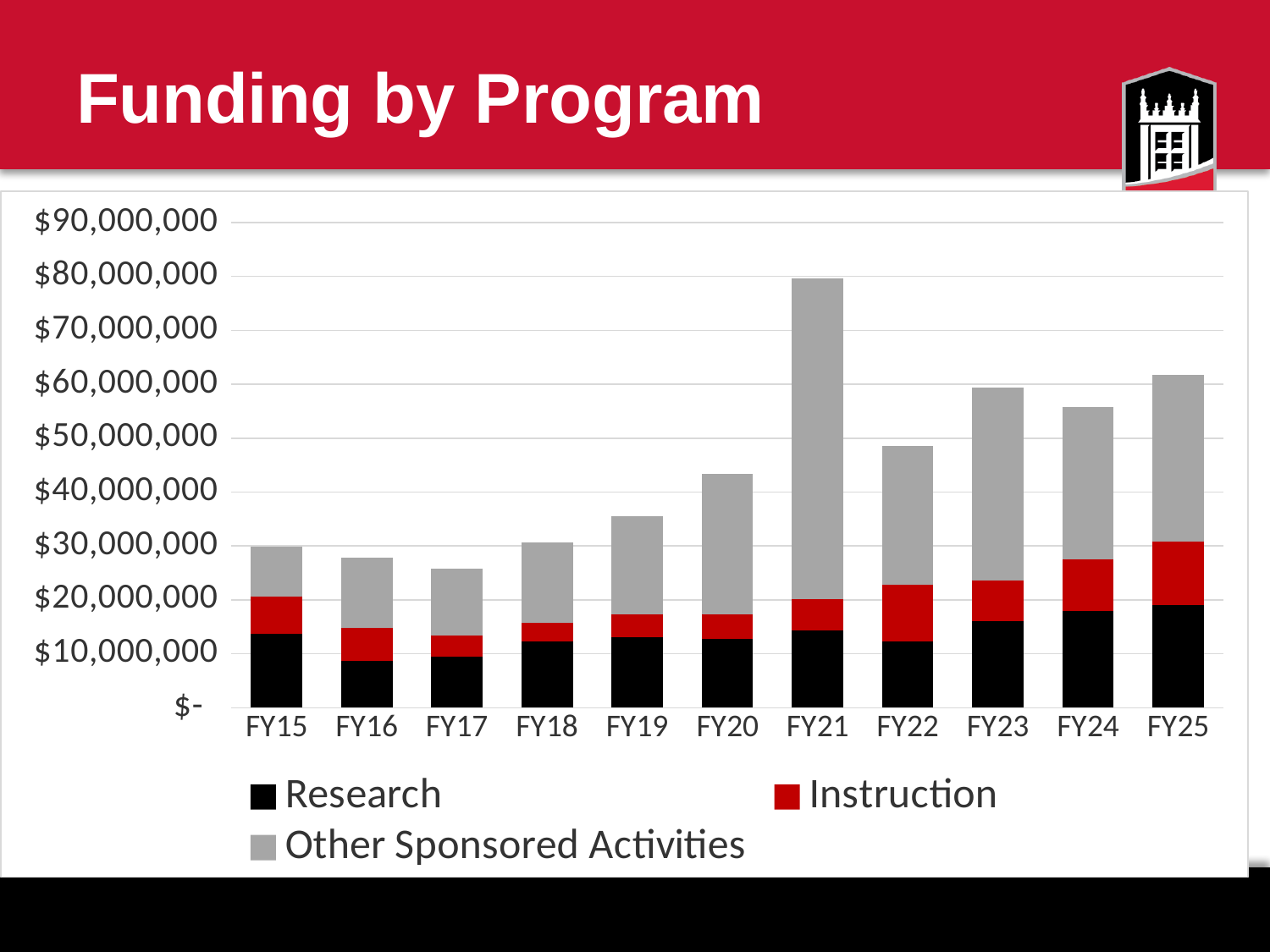
Which fiscal year has the lowest total funding? FY17 Is the total funding for FY20 greater or less than $40,000,000? greater Which has the larger total funding, FY21 or FY25? FY21 Which fiscal year has the highest total funding? FY21 Which series is shown in black? Research What kind of chart is shown on the slide? Stacked bar chart Does total funding rise or fall from FY17 to FY21? rise Which has the larger total funding, FY15 or FY17? FY15 Is the total funding for FY17 greater or less than $30,000,000? less Is the total funding for FY21 greater or less than $70,000,000? greater How many fiscal years are shown on the x axis? 11 How many series does the legend list? 3